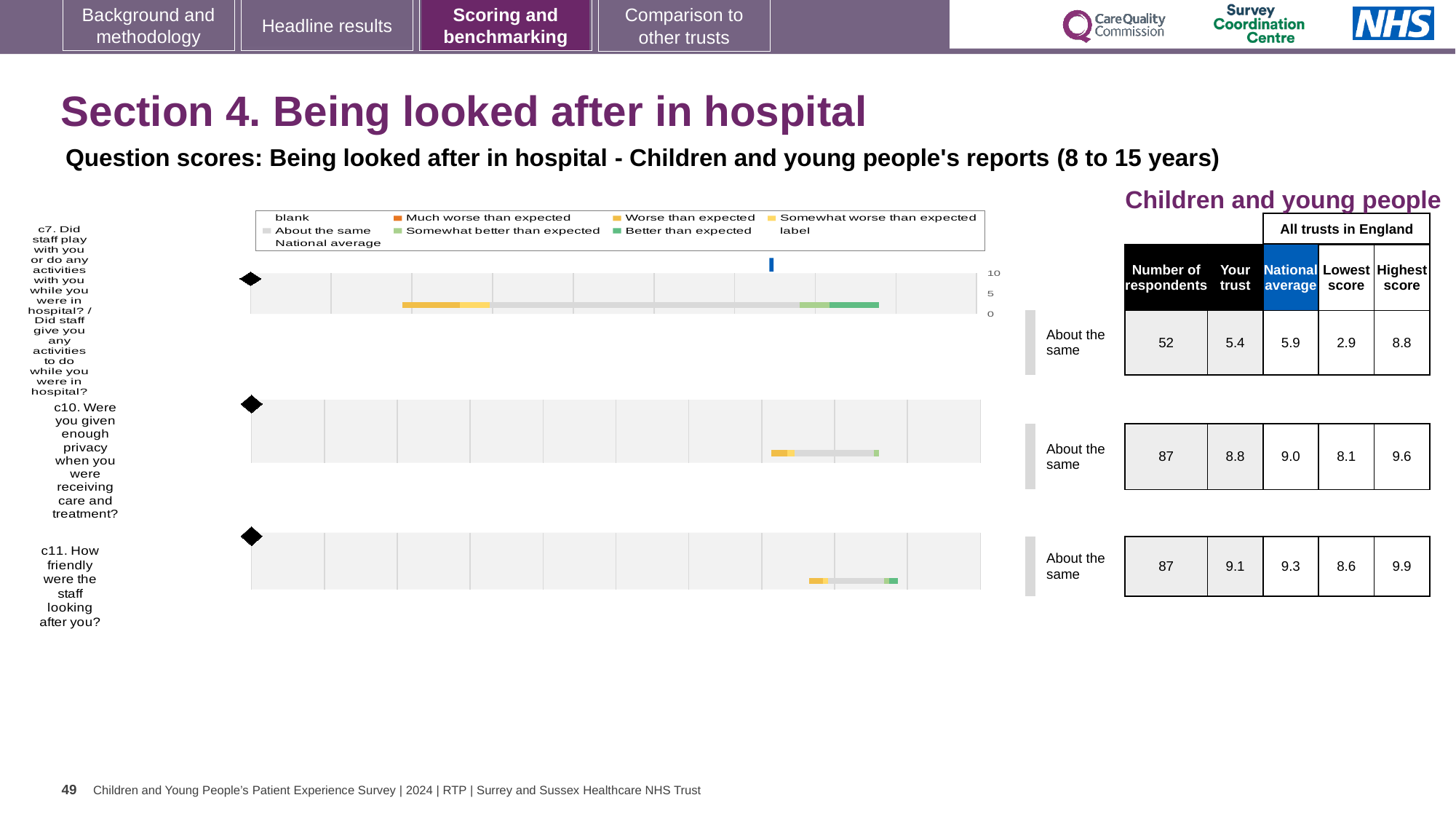
What is the lowest score among all trusts in England for question c10? 8.1 What benchmark category is shown for question c11? About the same How many respondents answered question c7? 52 For question c7 (Did staff play with you or do any activities with you while you were in hospital?), what is the 'Your trust' score shown? 5.4 For question c11 (How friendly were the staff looking after you?), what is the highest score among all trusts in England? 9.9 For question c10, is the 'Your trust' score or the national average score larger? National average What does the legend entry with the dark green colour represent? Better than expected What is the difference between the national average and the 'Your trust' score for question c7? 0.5 Which of the three questions (c7, c10, c11) has the highest 'Your trust' score? c11 How many questions are plotted on the slide? 3 For question c10 (Were you given enough privacy when you were receiving care and treatment?), what is the national average score? 9.0 Which of the three questions (c7, c10, c11) has the lowest 'Your trust' score? c7